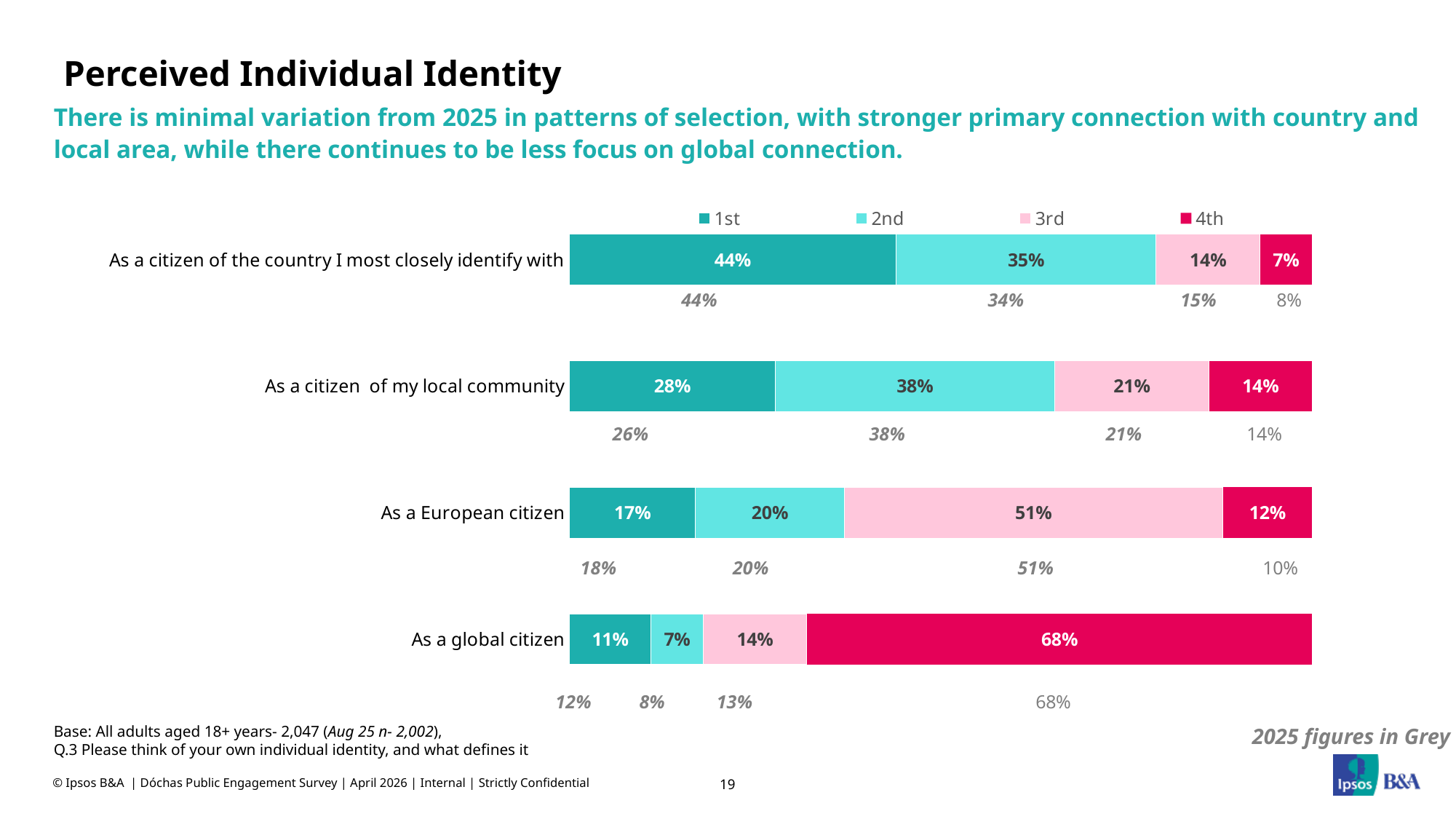
What percentage ranked 'As a citizen of the country I most closely identify with' 1st? 44% How many series does the legend list? 4 Which is larger: the 2nd-place share for 'As a citizen of my local community' or for 'As a citizen of the country I most closely identify with'? As a citizen of my local community What kind of chart is shown on the slide? Stacked bar chart What percentage ranked 'As a global citizen' 4th? 68% What was the 2025 figure (shown in grey) for 'As a citizen of my local community' ranked 1st? 26% How many identity categories are shown in the chart? 4 What percentage ranked 'As a citizen of my local community' 2nd? 38% What percentage ranked 'As a European citizen' 3rd? 51% Which category has the lowest share of 1st-place rankings? As a global citizen What is the difference between the 4th-place share for 'As a global citizen' and for 'As a European citizen'? 56% Which category has the highest share of 1st-place rankings? As a citizen of the country I most closely identify with